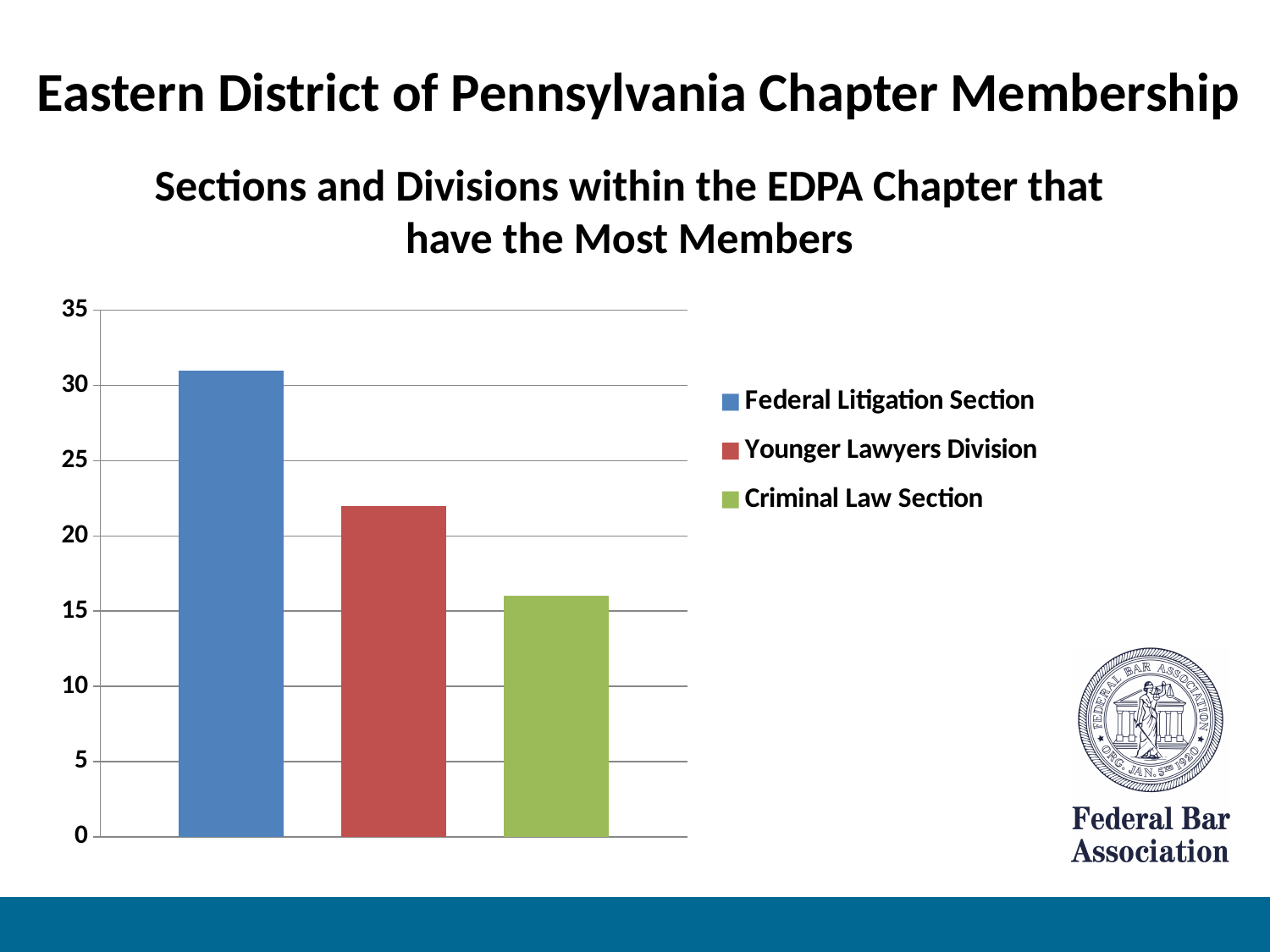
Is the value for the Younger Lawyers Division greater or less than 20? greater Which section or division has the most members? Federal Litigation Section Is the value for the Younger Lawyers Division greater or less than 25? less Which section or division has the fewest members? Criminal Law Section What kind of chart is shown on the slide? bar chart What is the title of the chart? Sections and Divisions within the EDPA Chapter that have the Most Members Which has more members, the Younger Lawyers Division or the Criminal Law Section? Younger Lawyers Division How many bars are plotted in the chart? 3 Is the value for the Federal Litigation Section greater or less than 30? greater What colour is the bar for the Criminal Law Section? green How many series does the legend list? 3